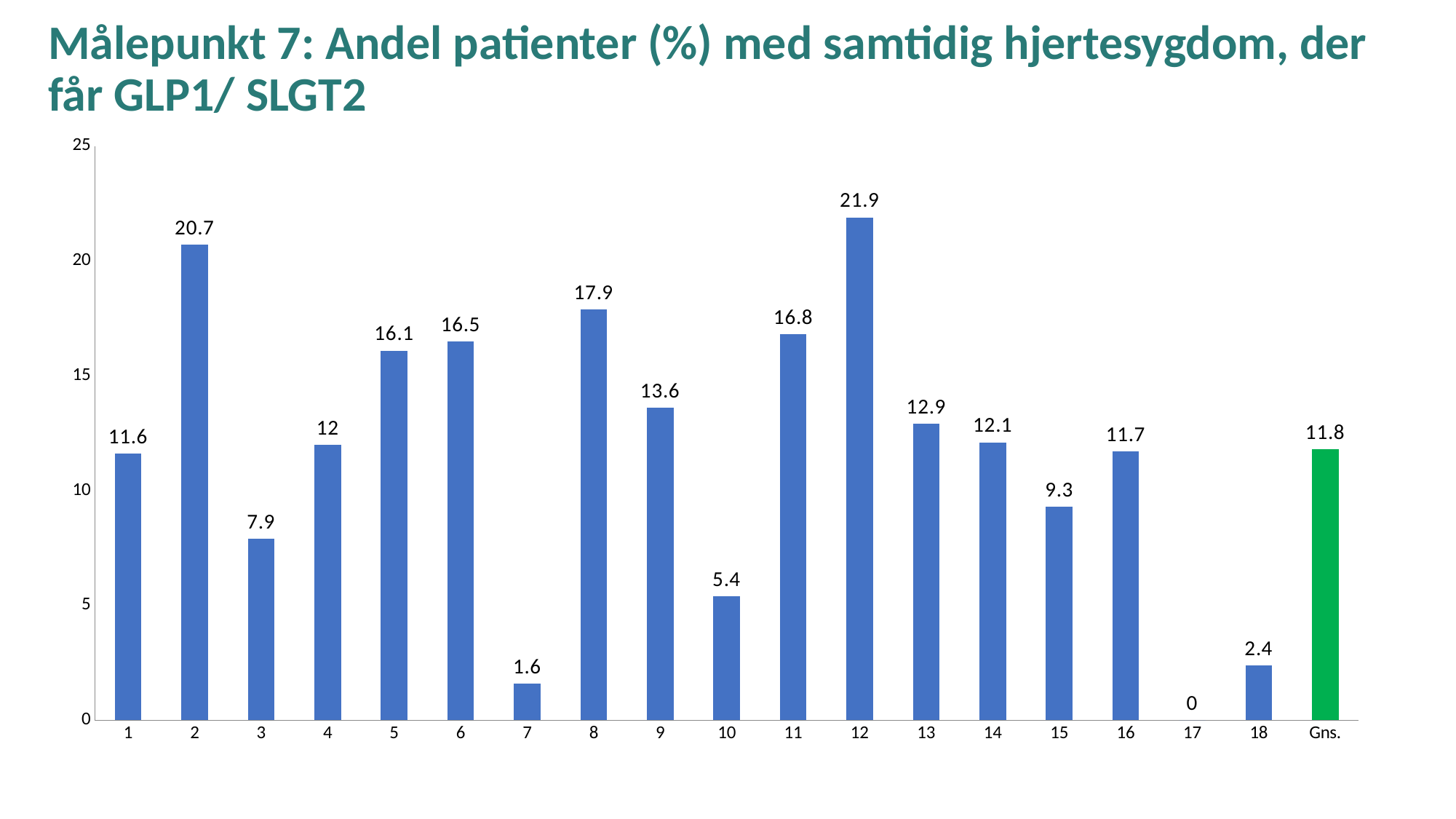
Which bar is shown in green rather than blue? Gns. Which category has the highest value? 12 What is the value for category 7? 1.6 Which category has the lowest value? 17 What is the value for category 12? 21.9 What is the value for category 18? 2.4 Is the value for category 8 greater or less than 15? greater What is the difference between the values for category 2 and category 3? 12.8 What is the value for the Gns. bar? 11.8 What kind of chart is shown on the slide? bar chart How many bars are shown in the chart? 19 Which is larger, the value for category 5 or the value for category 6? 6